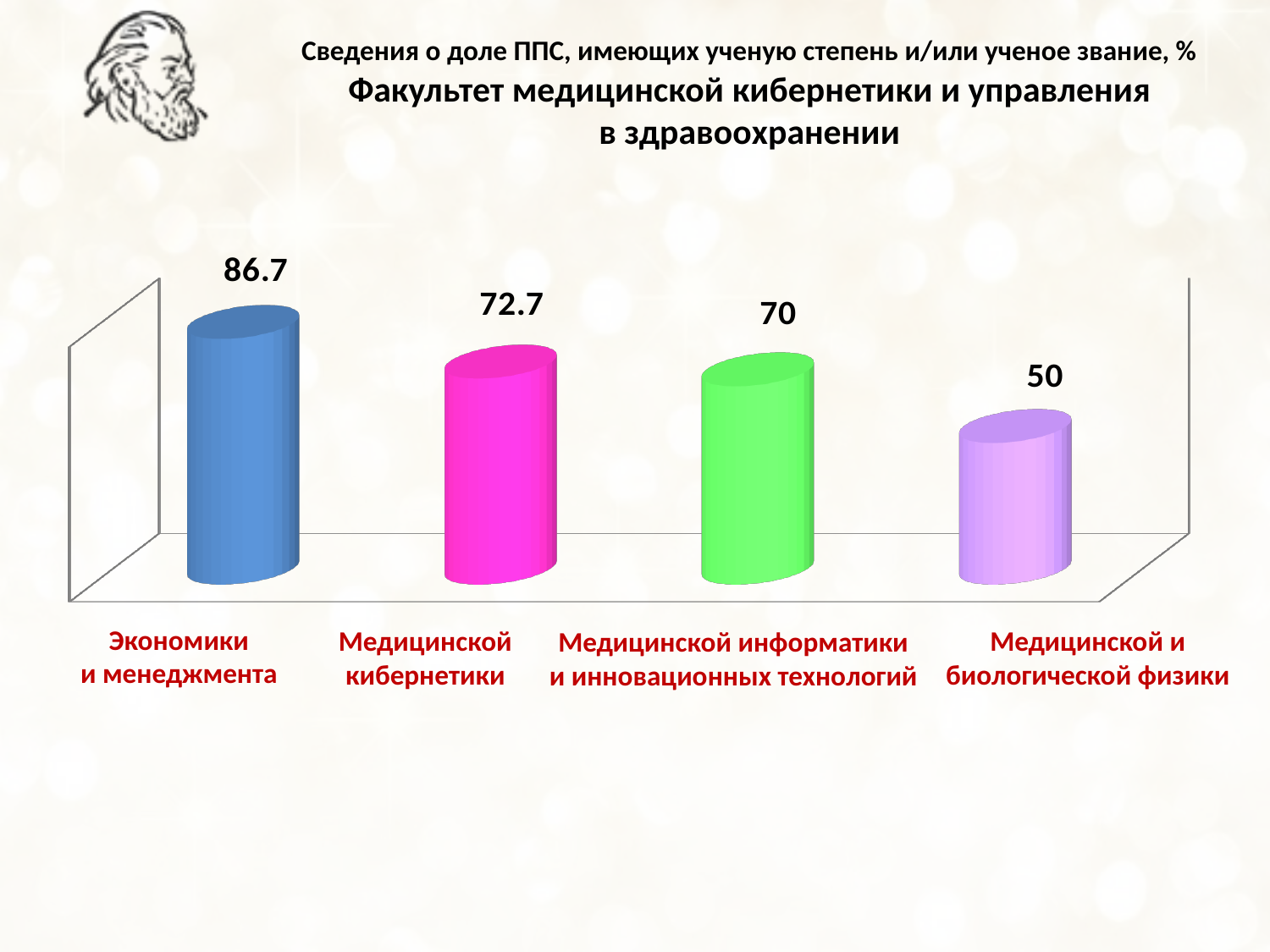
What is the value for Экономики и менеджмента? 86.7 What is the value for Медицинской информатики и инновационных технологий? 70 What is the difference between the values for Экономики и менеджмента and Медицинской и биологической физики? 36.7 How many departments are shown in the chart? 4 Which department has the highest value? Экономики и менеджмента Which is larger, the value for Медицинской кибернетики or the value for Медицинской и биологической физики? Медицинской кибернетики What is the difference between the values for Медицинской кибернетики and Медицинской информатики и инновационных технологий? 2.7 What kind of chart is shown on the slide? Bar chart Which department has the lowest value? Медицинской и биологической физики What is the value for Медицинской кибернетики? 72.7 Do the values rise or fall from left to right across the chart? Fall What is the value for Медицинской и биологической физики? 50